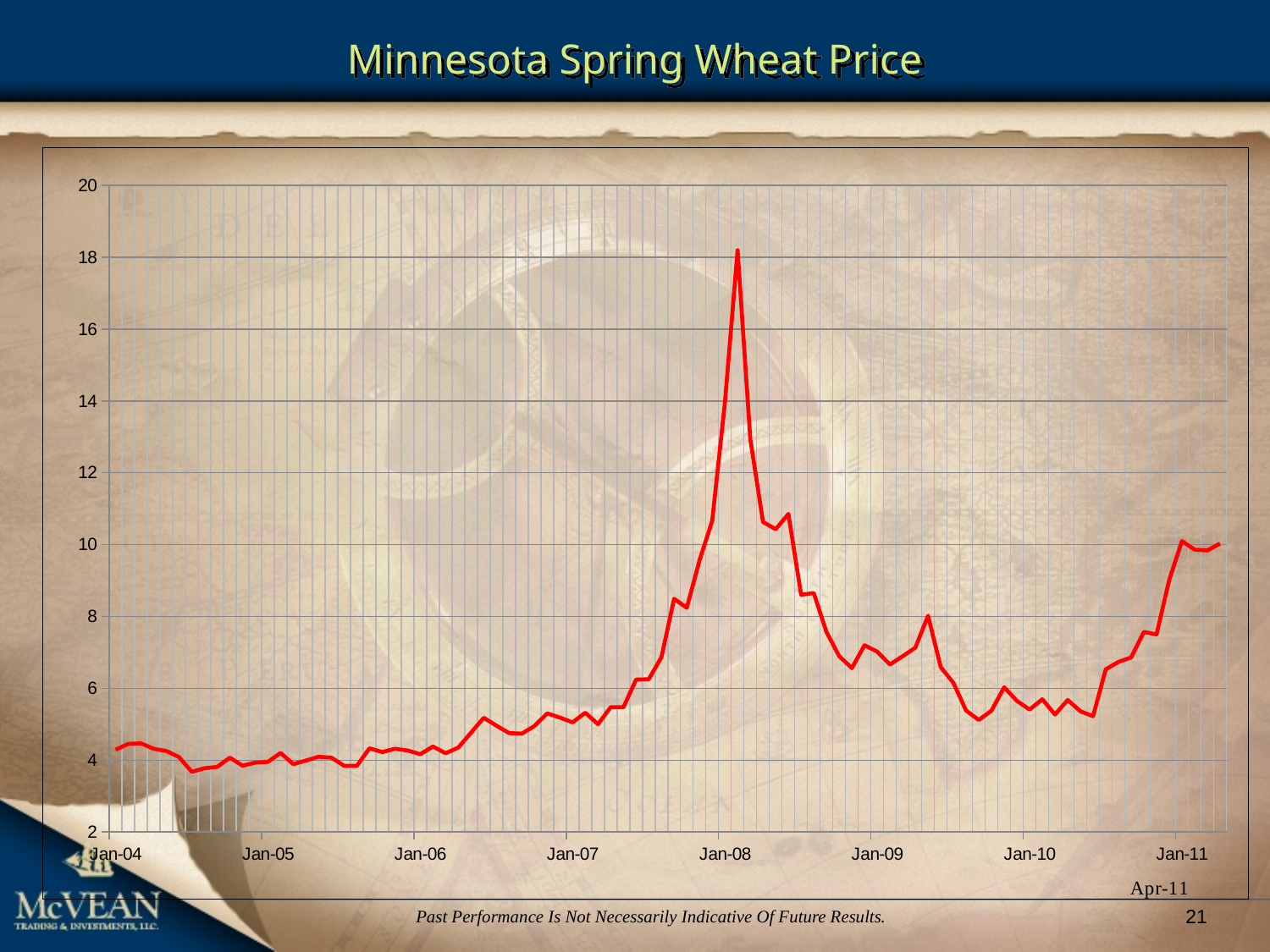
What is the title of the chart? Minnesota Spring Wheat Price Which is larger, the value at Jan-09 or the value at Jan-10? Jan-09 Is the value at Jan-10 greater or less than 8? less What kind of chart is shown on the slide? line chart What colour is the line plotted on the chart? red Is the value at Jan-11 greater or less than 8? greater Is the value at Jan-09 greater or less than 10? less Does the price rise or fall between Jan-04 and Jan-08? rise Around which x-axis label does the line reach its peak? Jan-08 How many year labels (Jan-04 through Jan-11) are shown on the x axis? 8